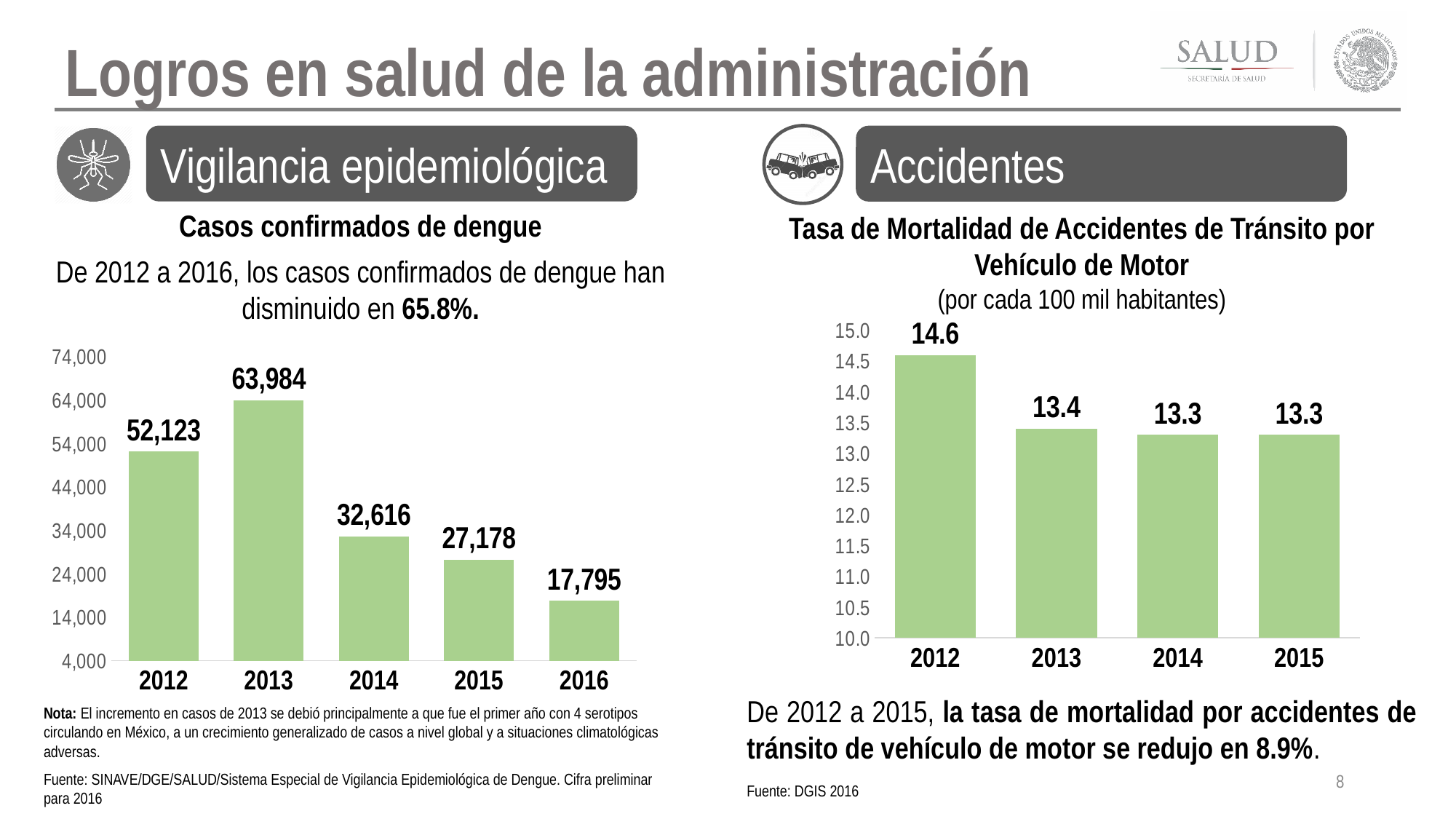
In the 'Tasa de Mortalidad de Accidentes de Tránsito por Vehículo de Motor' chart, what is the difference between the values for 2012 and 2015? 1.3 What type of chart is the 'Tasa de Mortalidad de Accidentes de Tránsito por Vehículo de Motor' chart? bar chart In the 'Casos confirmados de dengue' chart, what is the difference between the values for 2014 and 2015? 5,438 In the 'Casos confirmados de dengue' chart, which year has the lowest value? 2016 In the 'Casos confirmados de dengue' chart, how many years are shown? 5 In the 'Tasa de Mortalidad de Accidentes de Tránsito por Vehículo de Motor' chart, what is the value for 2012? 14.6 In the 'Casos confirmados de dengue' chart, what is the value for 2013? 63,984 In the 'Casos confirmados de dengue' chart, do the values rise or fall from 2013 to 2016? fall In the 'Casos confirmados de dengue' chart, which year has the highest value? 2013 In the 'Tasa de Mortalidad de Accidentes de Tránsito por Vehículo de Motor' chart, which year has the highest value? 2012 In the 'Tasa de Mortalidad de Accidentes de Tránsito por Vehículo de Motor' chart, what is the value for 2013? 13.4 In the 'Casos confirmados de dengue' chart, what is the value for 2016? 17,795